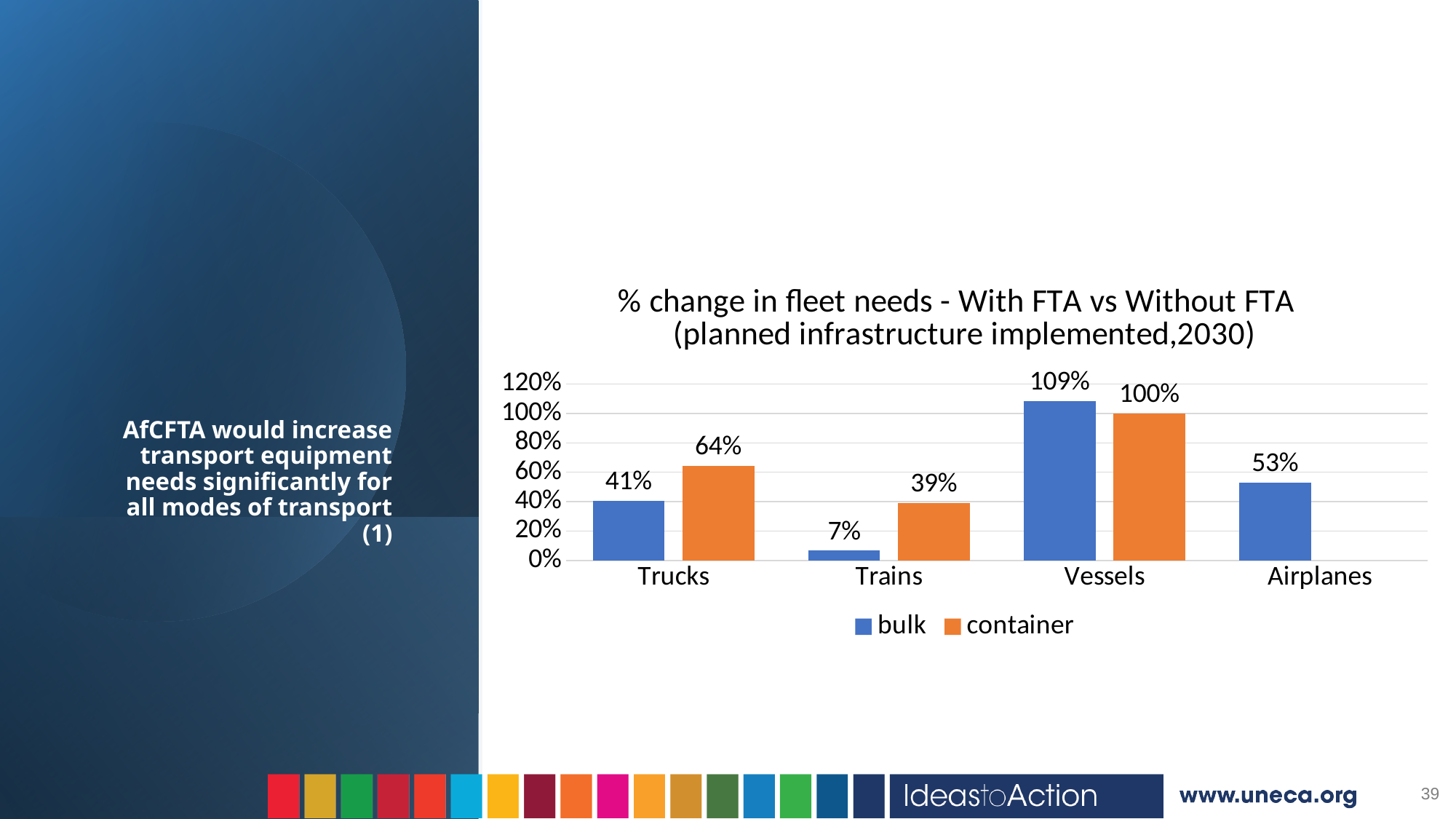
How many series does the legend list? 2 Which category has the lowest bulk value? Trains What is the container value for Trains? 39% What is the bulk value for Airplanes? 53% Which category has the highest bulk value? Vessels What is the bulk value for Trucks? 41% How many categories are shown on the x axis? 4 Which is larger for Trains, the bulk value or the container value? container What is the difference between the container and bulk values for Trucks? 23% What kind of chart is shown on the slide? bar chart What colour are the container bars? orange What is the difference between the bulk and container values for Vessels? 9%